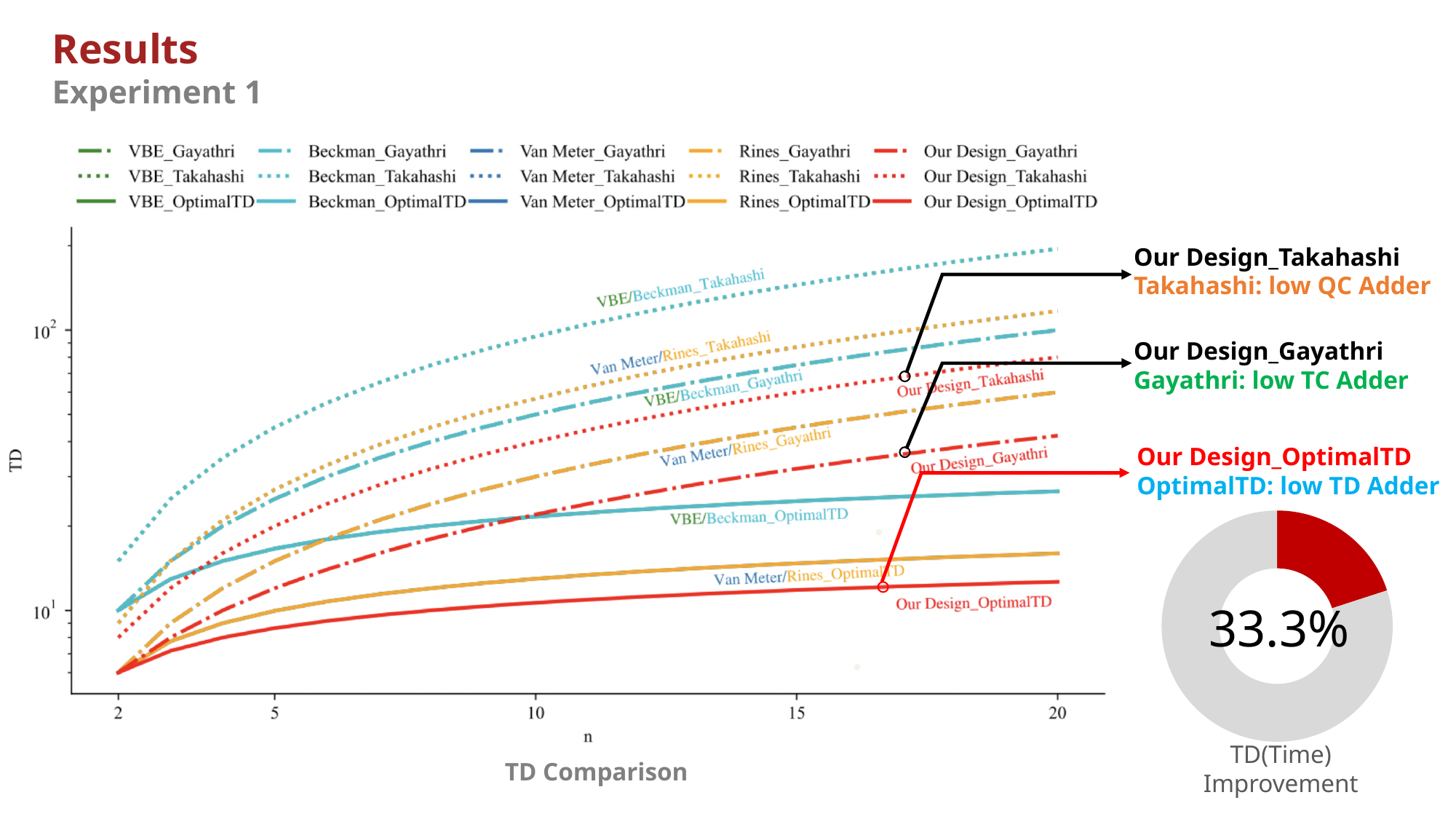
In the 'TD Comparison' chart, is the TD value for VBE/Beckman_Takahashi at n = 20 greater or less than 100? greater In the 'TD Comparison' chart, which series has the lowest TD at n = 20? Our Design_OptimalTD What kind of chart is the 'TD(Time) Improvement' chart on the right of the slide? Donut (pie) chart What kind of chart is the 'TD Comparison' chart? Line chart What percentage is shown in the 'TD(Time) Improvement' donut chart? 33.3% In the 'TD Comparison' chart, which is larger at n = 20: the TD of VBE/Beckman_OptimalTD or the TD of Van Meter/Rines_OptimalTD? VBE/Beckman_OptimalTD How many series does the legend of the 'TD Comparison' chart list? 15 In the 'TD Comparison' chart, which is larger at n = 20: the TD of Our Design_Takahashi or the TD of Our Design_OptimalTD? Our Design_Takahashi In the 'TD Comparison' chart, is the TD value for Our Design_OptimalTD at n = 20 greater or less than 100? less What is the label of the x axis of the 'TD Comparison' chart? n In the 'TD Comparison' chart, is the TD value for Our Design_OptimalTD at n = 20 greater or less than 10? greater In the 'TD Comparison' chart, do the TD values rise or fall as n increases? Rise